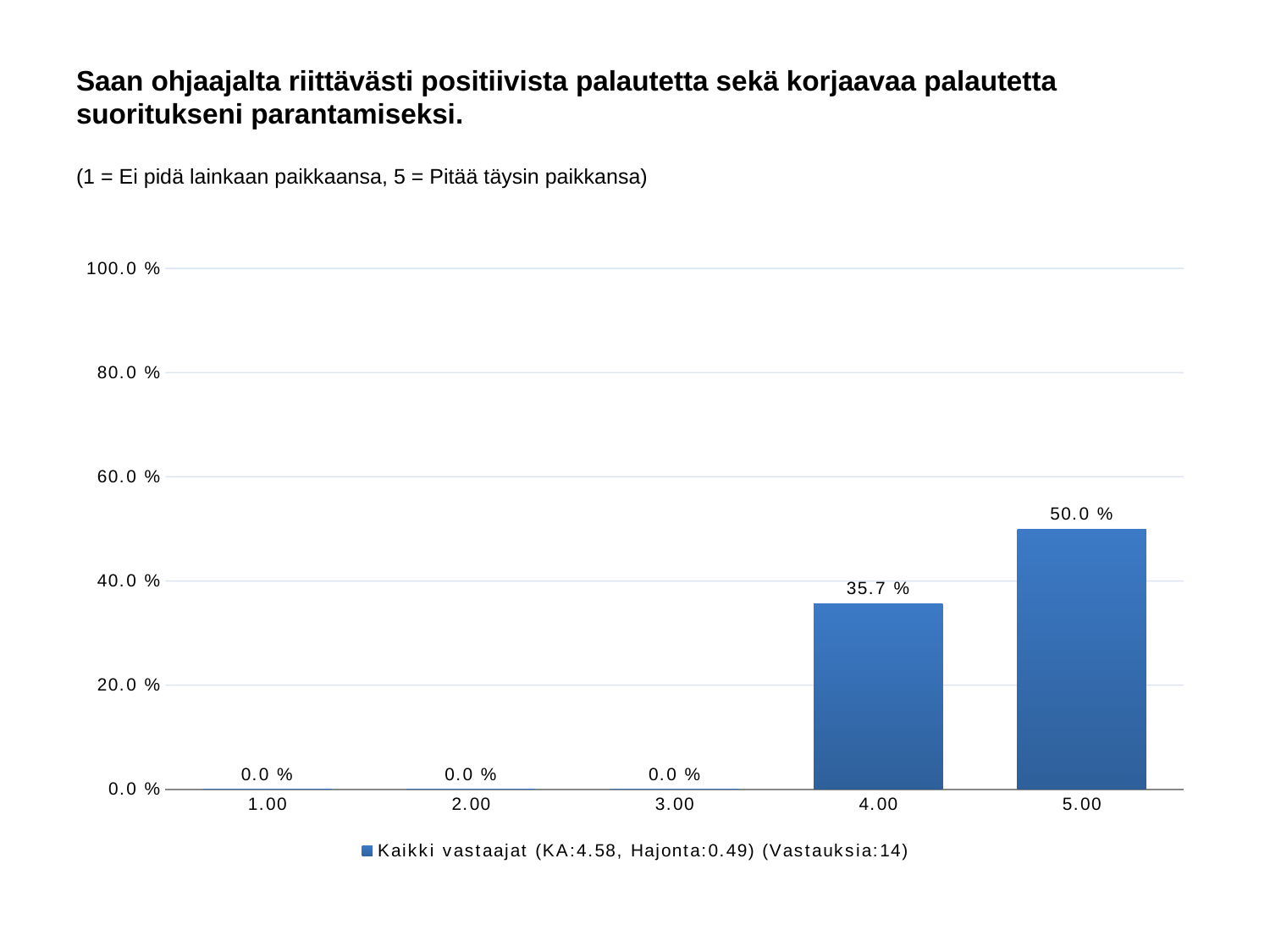
Which is larger, the value for 4.00 or the value for 5.00? 5.00 How many series does the legend list? 1 Is the value for 4.00 greater or less than 40.0 %? less What is the value for category 5.00? 50.0 % What is the value for category 4.00? 35.7 % What is the value for category 1.00? 0.0 % What kind of chart is this? bar chart How many responses (Vastauksia) does the legend report? 14 How many categories are shown on the x axis? 5 What is the difference between the values for 5.00 and 4.00? 14.3 % Which category has the highest value? 5.00 Do the values rise or fall from category 3.00 to 5.00? rise